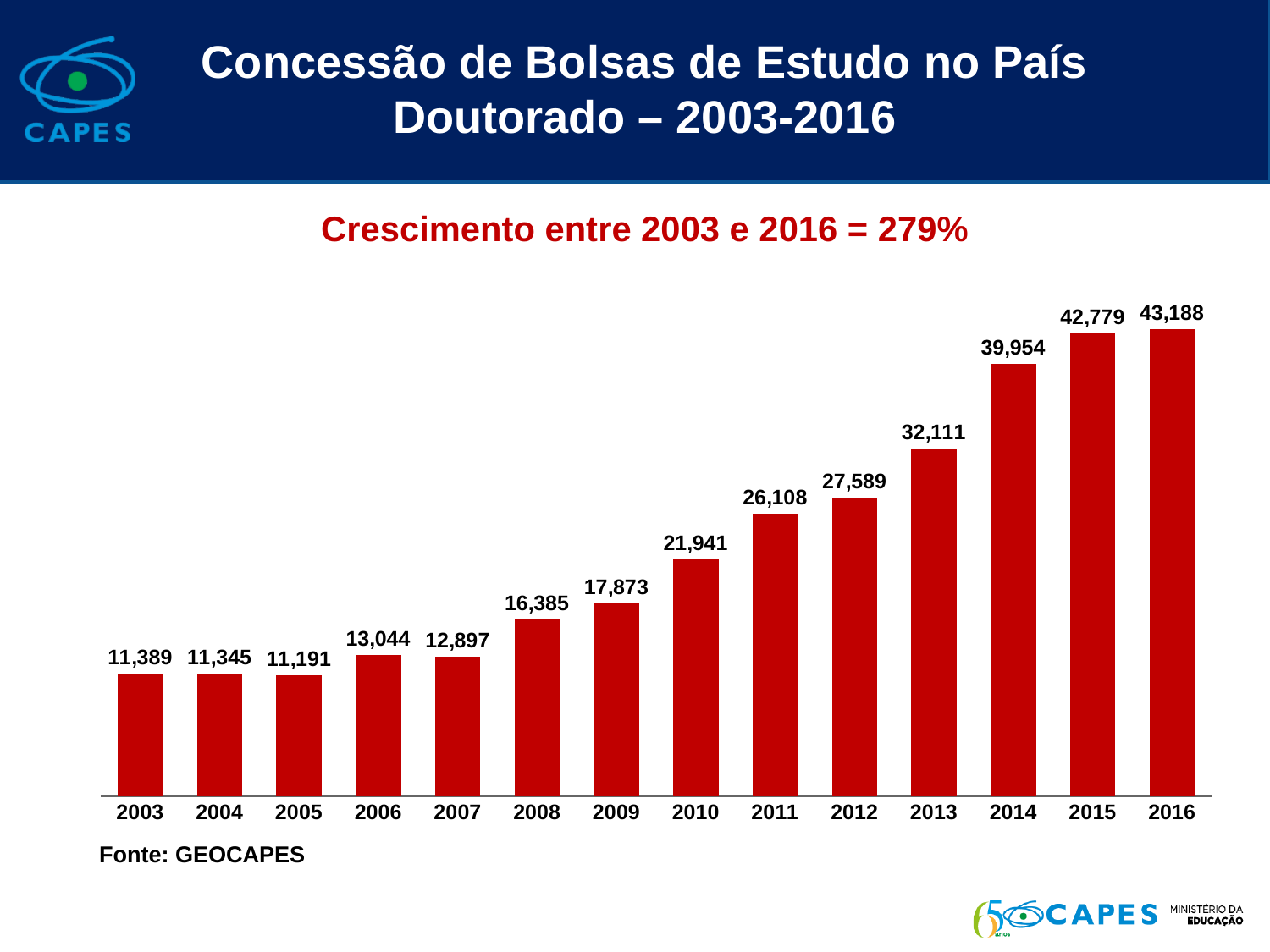
Do the values generally rise or fall from 2005 to 2016? rise Which year has the lowest value? 2005 How many years are shown on the x axis? 14 Which is larger, the value for 2006 or the value for 2007? 2006 What is the value for 2010? 21,941 What is the value for 2014? 39,954 What is the value for 2003? 11,389 What is the source cited below the chart? GEOCAPES Which year has the highest value? 2016 What is the difference between the values for 2013 and 2012? 4,522 What is the difference between the values for 2016 and 2015? 409 What kind of chart is this? bar chart